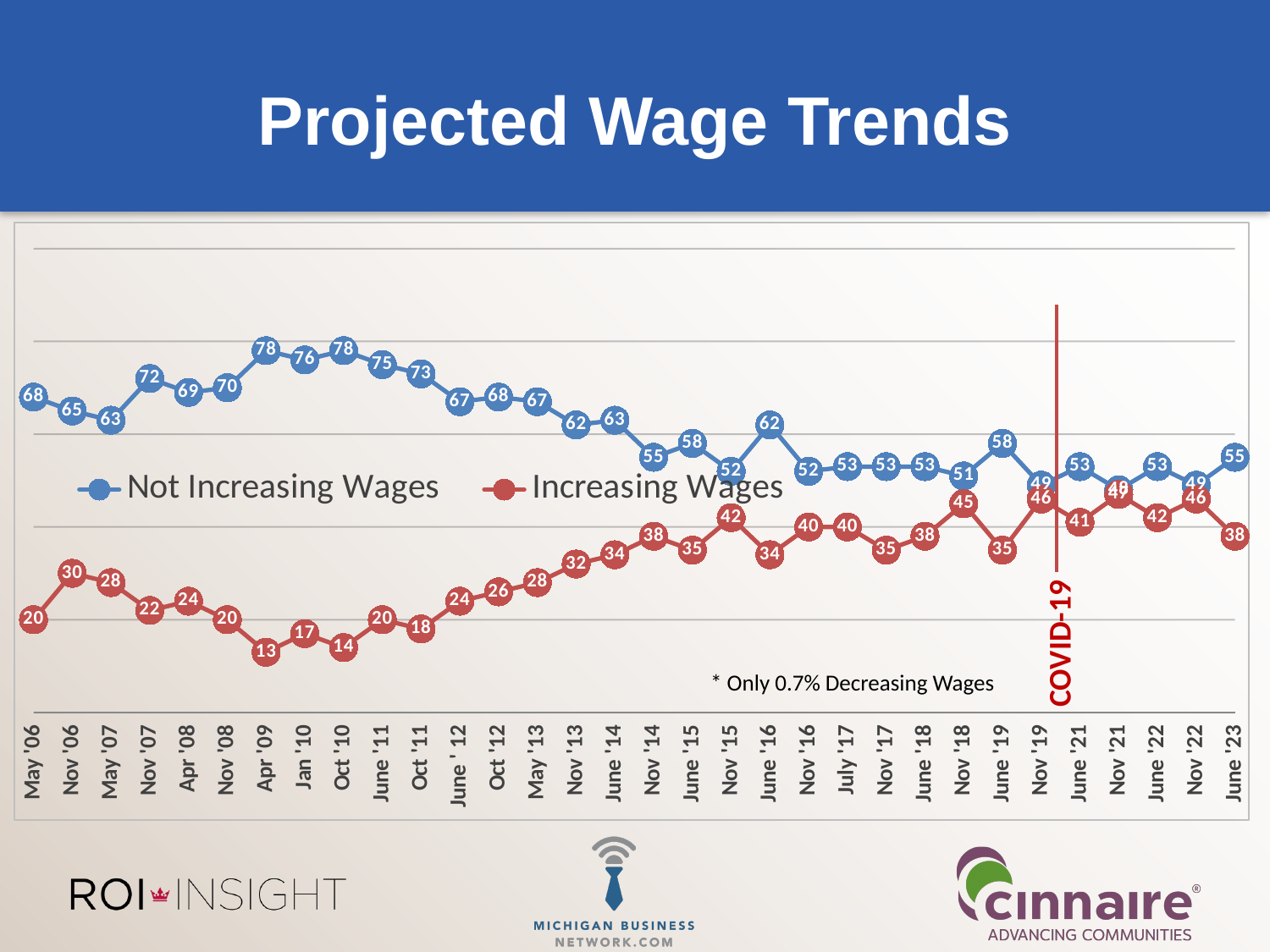
Does the Increasing Wages series rise or fall between Apr '09 and Nov '15? rise How many series does the legend list? 2 At which date is the Increasing Wages series at its lowest? Apr '09 What kind of chart is shown on the slide? line chart What is the value for Increasing Wages at Apr '09? 13 At June '23, what is the difference between Not Increasing Wages and Increasing Wages? 17 What is the value for Not Increasing Wages at May '06? 68 What are the two series named in the legend? Not Increasing Wages and Increasing Wages What is the highest value reached by the Not Increasing Wages series? 78 What is the value for Not Increasing Wages at June '23? 55 What is the value for Increasing Wages at June '23? 38 At Nov '15, which series has the larger value, Not Increasing Wages or Increasing Wages? Not Increasing Wages